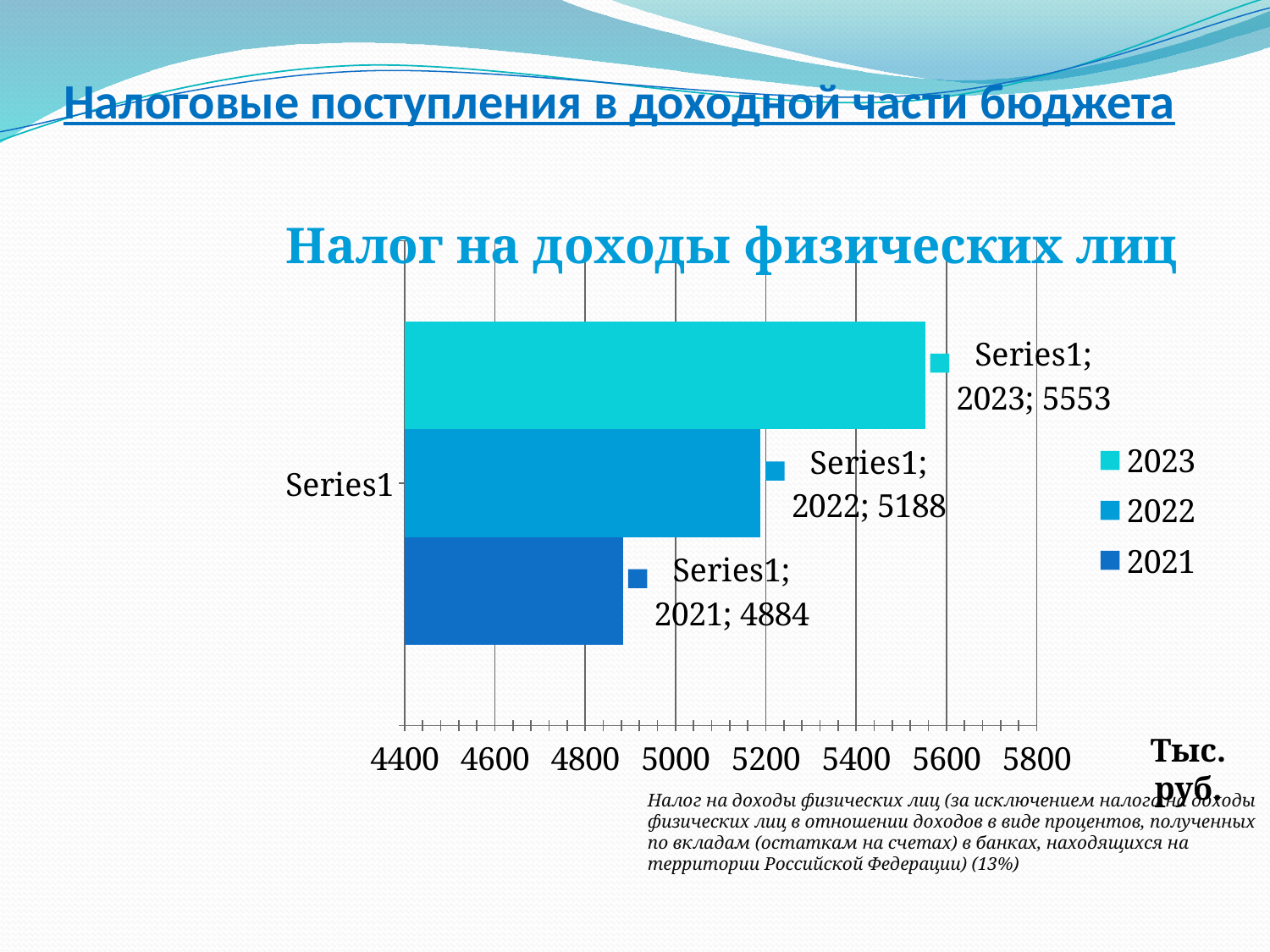
What is the value for 2023 in the chart? 5553 What is the title of the chart? Налог на доходы физических лиц What is the difference between the values for 2022 and 2021? 304 Which year has the lowest value in the chart? 2021 What is the difference between the values for 2023 and 2022? 365 What is the value for 2021 in the chart? 4884 Is the value for 2021 greater or less than 5000? less What is the value for 2022 in the chart? 5188 Which year has the highest value in the chart? 2023 How many bars are plotted in the chart? 3 What type of chart is shown on the slide? bar chart Which is larger, the value for 2022 or the value for 2021? 2022